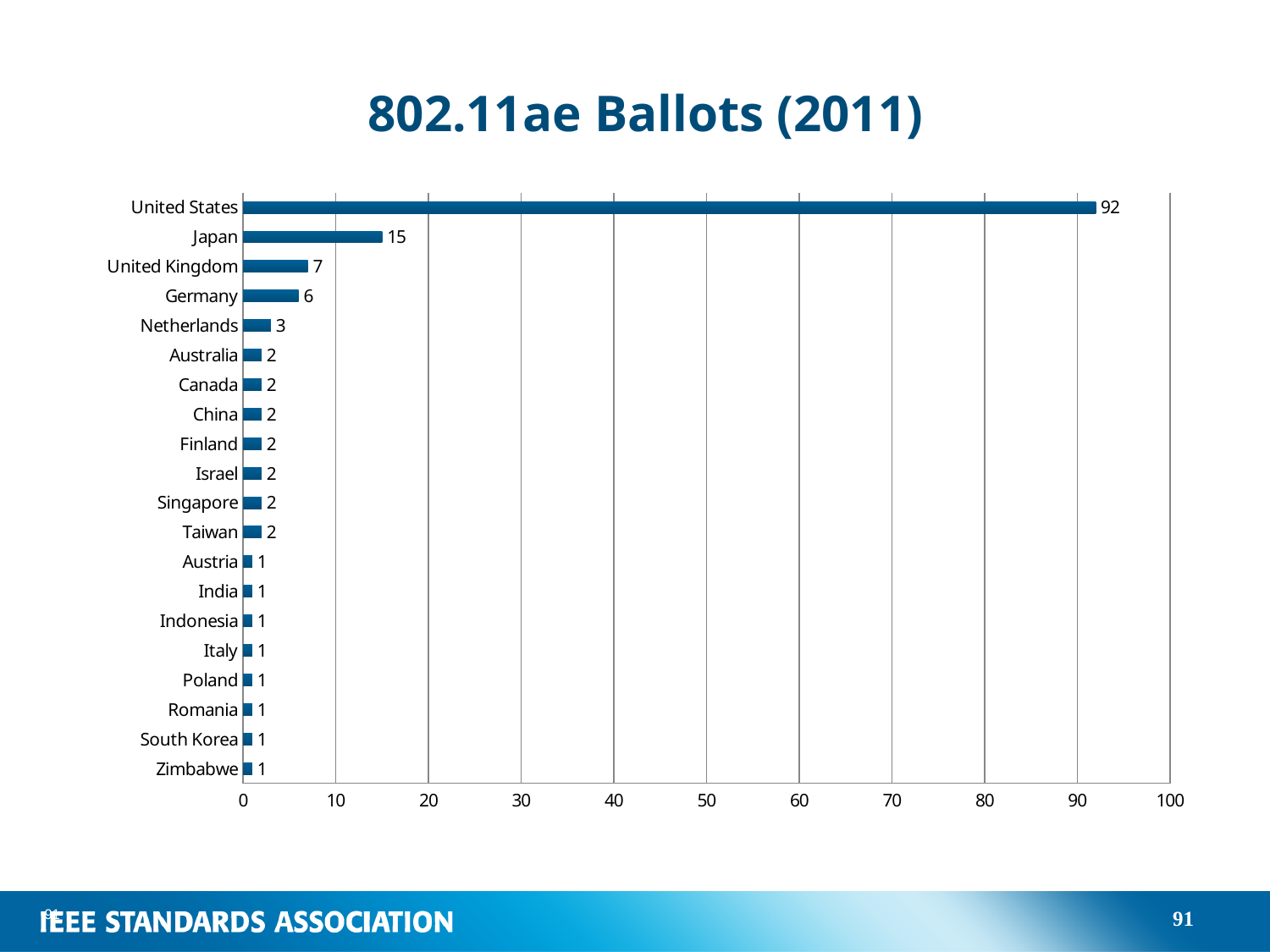
What is the value for Germany? 6 What is the value for Japan? 15 Is the value for the United States greater or less than 90? greater What is the title of the chart? 802.11ae Ballots (2011) Which is larger, the value for Japan or the value for the United Kingdom? Japan What is the difference between the values for the United Kingdom and Germany? 1 What is the value for the United States? 92 Which country has the highest value? United States What kind of chart is shown on the slide? bar chart How many countries are shown in the chart? 20 What is the value for the Netherlands? 3 What is the difference between the values for the United States and Japan? 77